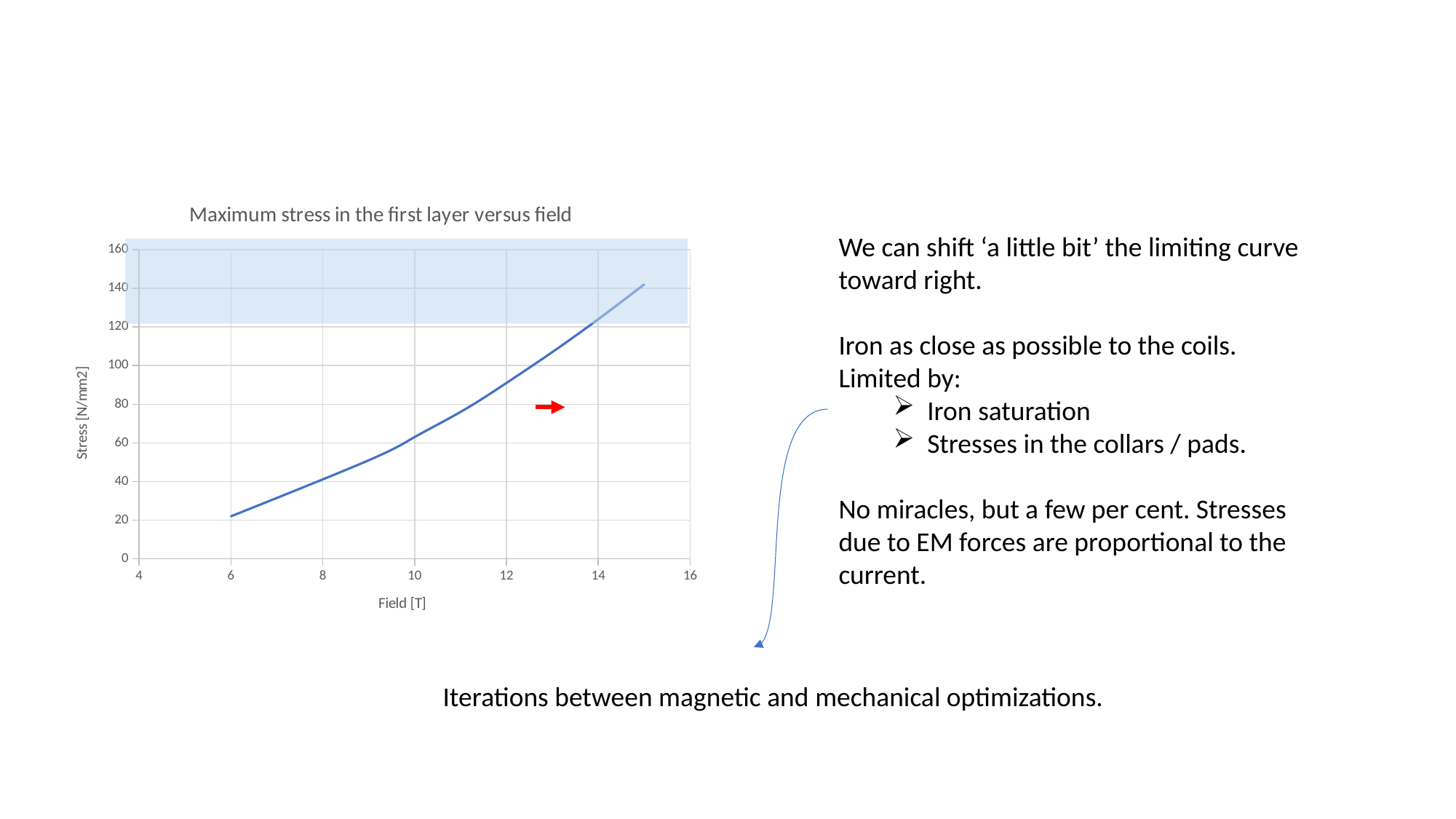
Is the stress at a field of 12 T greater or less than 80 N/mm2? greater Is the stress at the right end of the curve (about 15 T) greater or less than 120 N/mm2? greater Is the stress at a field of 10 T greater or less than 100 N/mm2? less What kind of chart is shown on the slide? line chart As the field increases along the x axis, does the stress rise or fall? rise What is the label of the y axis of the chart? Stress [N/mm2] What is the title of the chart? Maximum stress in the first layer versus field What is the highest value shown on the y axis of the chart? 160 Which has the higher stress: a field of 8 T or a field of 12 T? 12 T